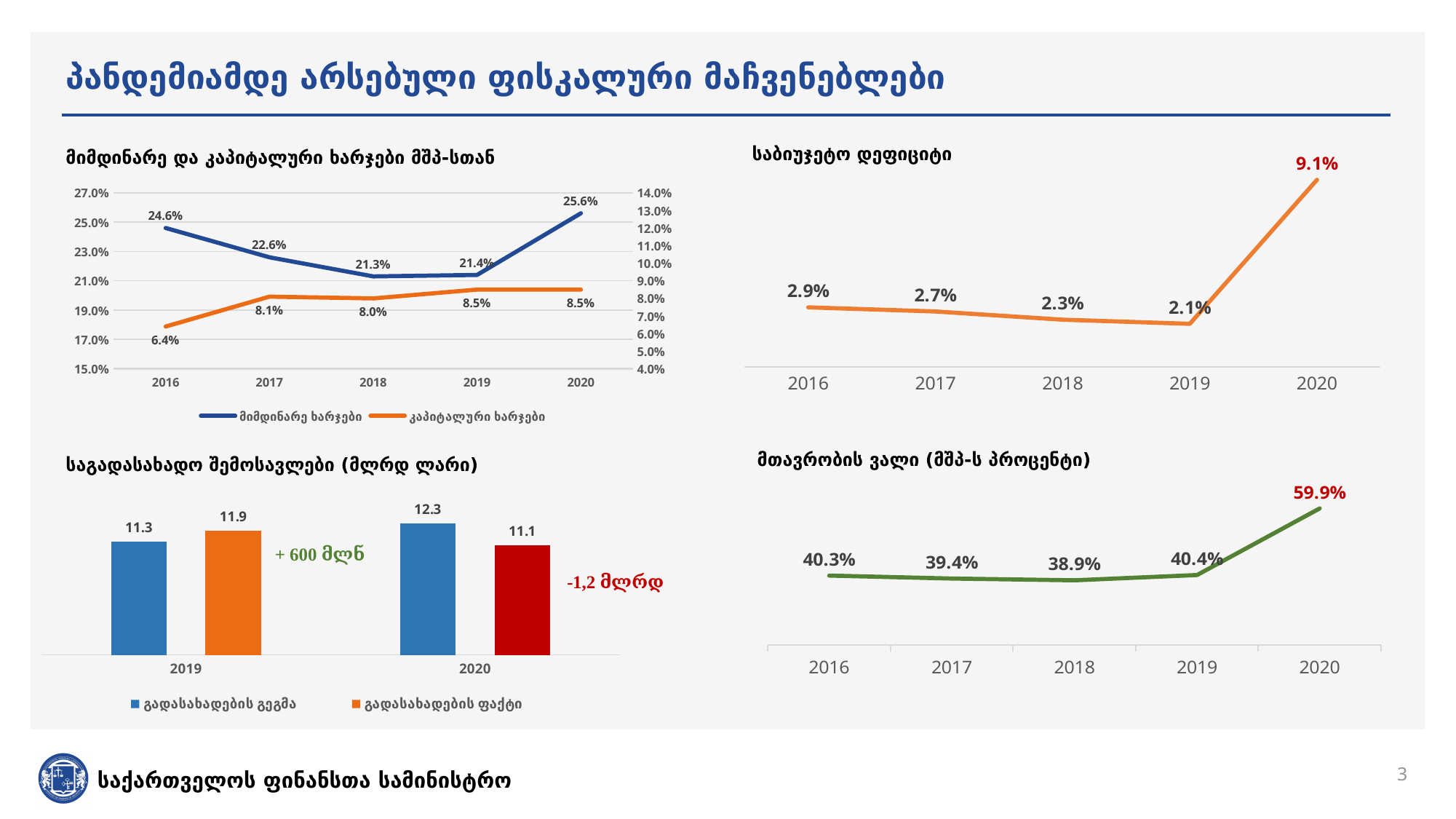
In the top-left chart, what is the value of კაპიტალური ხარჯები for 2016? 6.4% In the top-right chart (საბიუჯეტო დეფიციტი), what is the value for 2020? 9.1% In the top-left chart, what is the value of მიმდინარე ხარჯები for 2017? 22.6% In the bottom-right chart (მთავრობის ვალი), what is the difference between the 2020 and 2019 values? 19.5% In the bottom-right chart (მთავრობის ვალი), what is the value for 2018? 38.9% In the top-left chart, how many series does the legend list? 2 In the bottom-left chart, which is larger for 2019: გადასახადების გეგმა or გადასახადების ფაქტი? გადასახადების ფაქტი In the bottom-left chart, what is the value of გადასახადების ფაქტი for 2020? 11.1 What kind of chart is the bottom-left chart (საგადასახადო შემოსავლები)? bar chart In the top-right chart (საბიუჯეტო დეფიციტი), which year has the lowest value? 2019 In the bottom-right chart (მთავრობის ვალი), how many years are plotted? 5 In the top-left chart, which year has the highest value for მიმდინარე ხარჯები? 2020